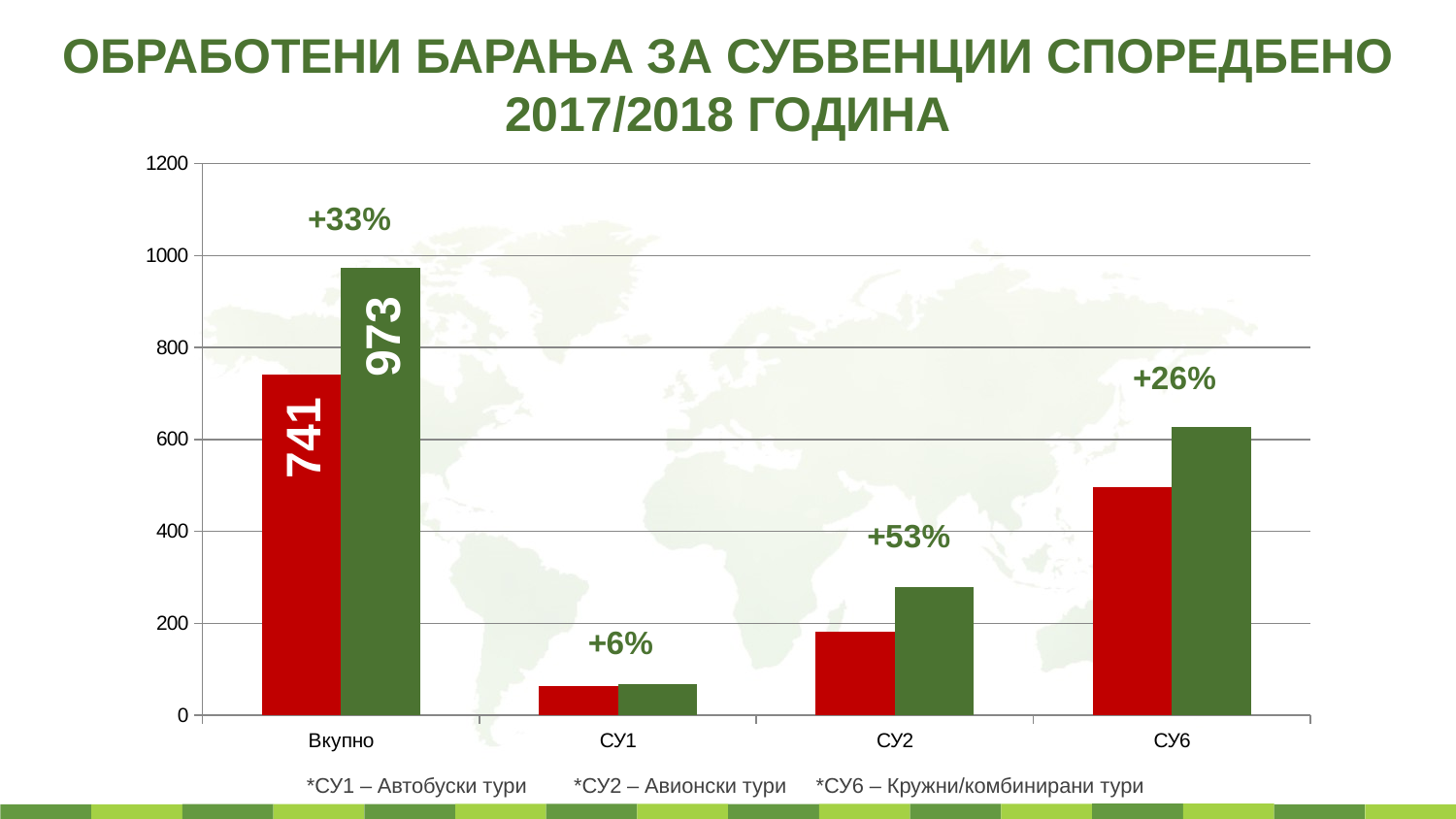
What is the difference between the green bar and the red bar for Вкупно? 232 What is the value of the green bar for Вкупно? 973 Is the value of the red bar for СУ2 greater or less than 200? less What percentage change is shown above the bars for СУ2? +53% Is the value of the green bar for СУ6 greater or less than 600? greater Which category has the shortest bars? СУ1 How many categories are shown on the x axis? 4 Which category has the tallest bars? Вкупно Which category has the larger green bar, СУ2 or СУ6? СУ6 What percentage change is shown above the bars for СУ1? +6% What kind of chart is shown on the slide? bar chart What is the value of the red bar for Вкупно? 741